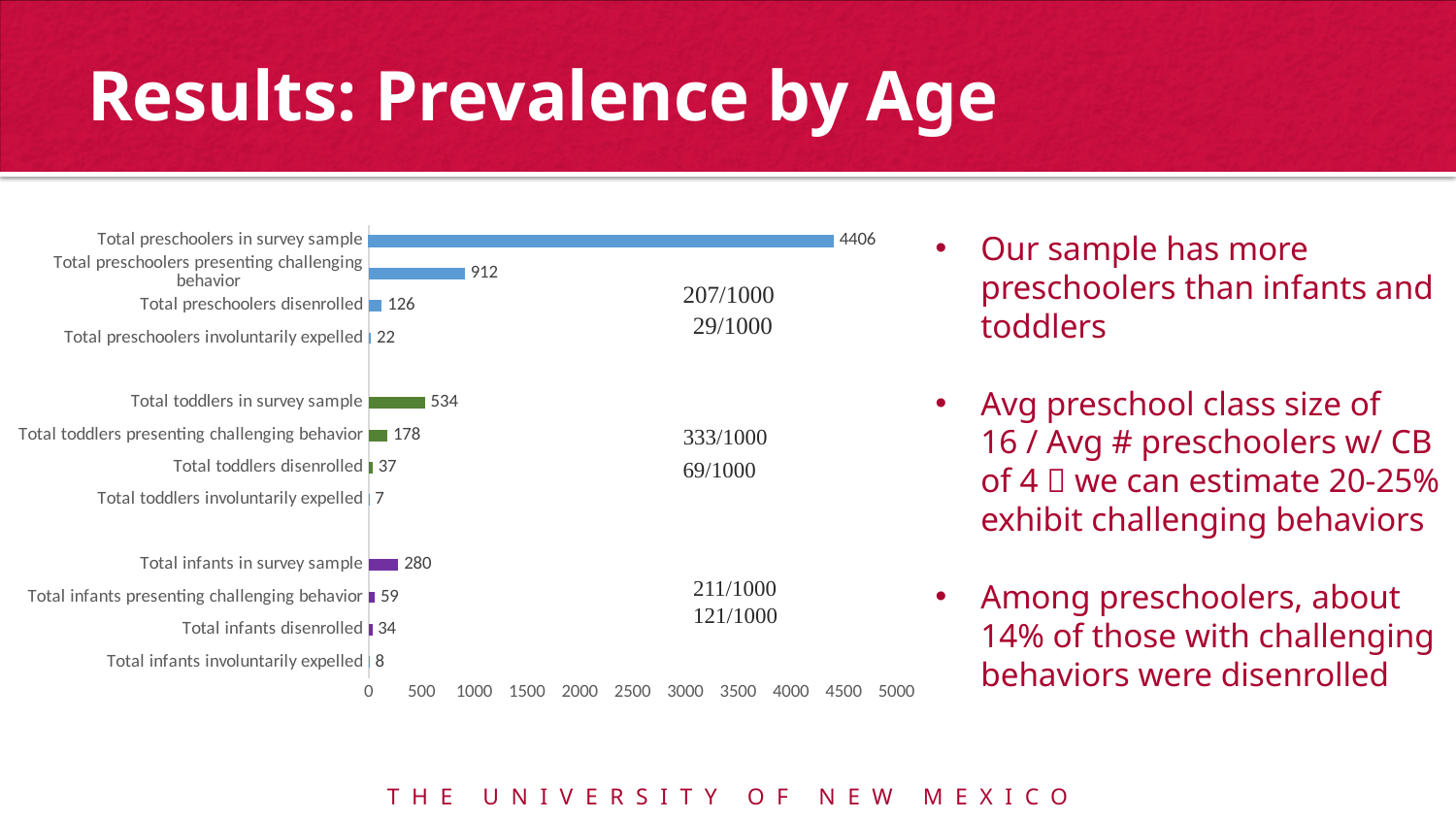
Which is larger: Total infants in survey sample or Total toddlers presenting challenging behavior? Total infants in survey sample What is the difference between Total preschoolers in survey sample and Total preschoolers presenting challenging behavior? 3494 How many categories are plotted in the chart? 12 Which category has the highest value in the chart? Total preschoolers in survey sample Which category has the lowest value in the chart? Total toddlers involuntarily expelled What is the value for Total infants disenrolled? 34 What is the value for Total preschoolers in survey sample? 4406 What kind of chart is shown on the slide? bar chart What is the value for Total toddlers presenting challenging behavior? 178 What is the value for Total preschoolers involuntarily expelled? 22 What is the difference between Total toddlers in survey sample and Total infants in survey sample? 254 Is the value for Total preschoolers in survey sample greater or less than 4000? greater